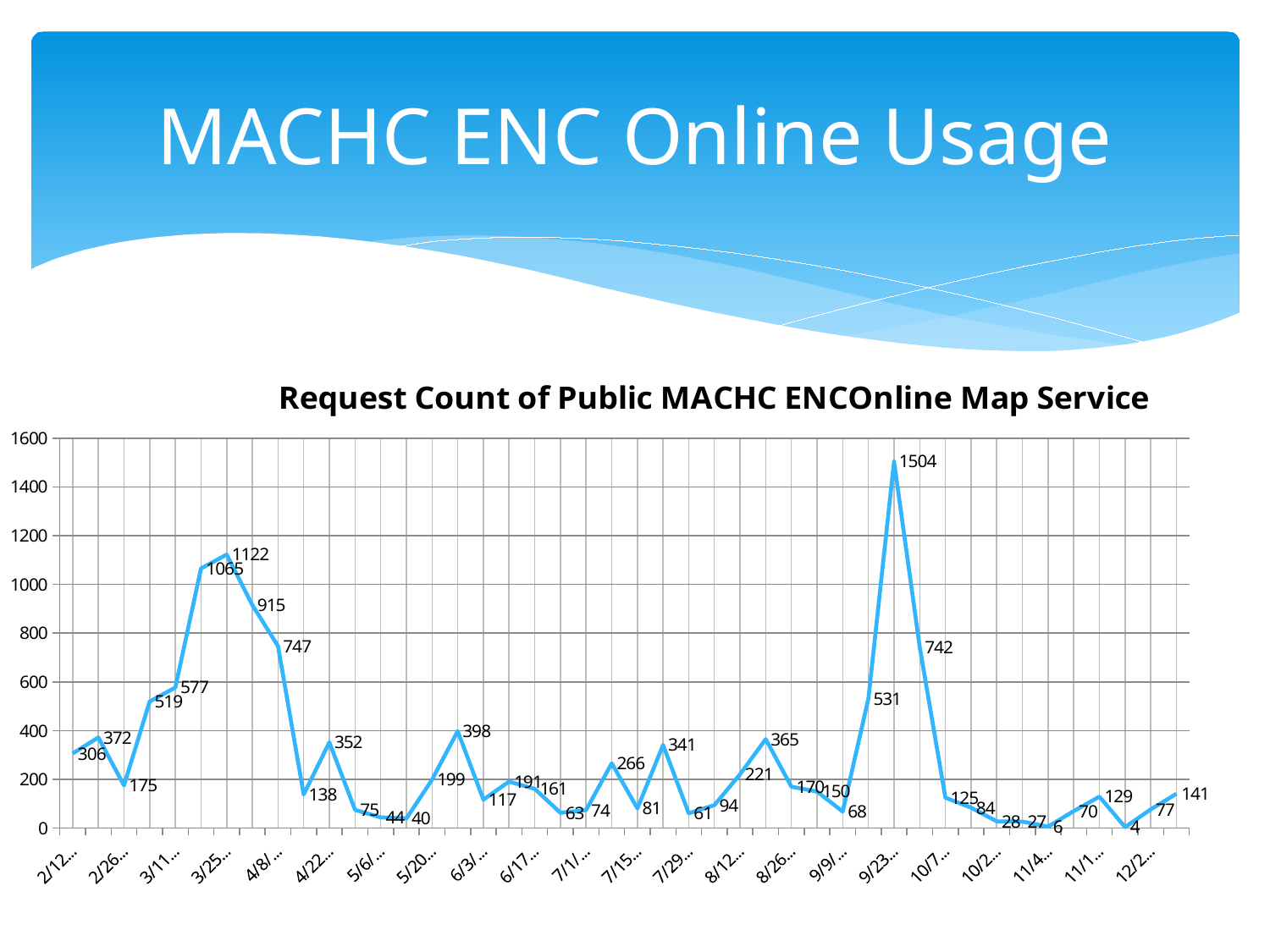
What is the value of the last data point on the chart? 141 Do the values rise or fall from the point labeled 1122 to the point labeled 747? fall What is the difference between the labeled values 742 and 531 on the chart? 211 What is the highest request count value labeled on the chart? 1504 Is the peak value of the chart greater or less than 1400? greater What is the difference between the labeled values 1122 and 1065 on the chart? 57 What is the title of the chart? Request Count of Public MACHC ENCOnline Map Service Which is larger, the point labeled 915 or the point labeled 747? 915 What is the value of the first data point on the chart (at 2/12)? 306 What kind of chart is shown on the slide? line chart What is the lowest request count value labeled on the chart? 4 What is the difference between the highest labeled value (1504) and the second-highest labeled value (1122)? 382